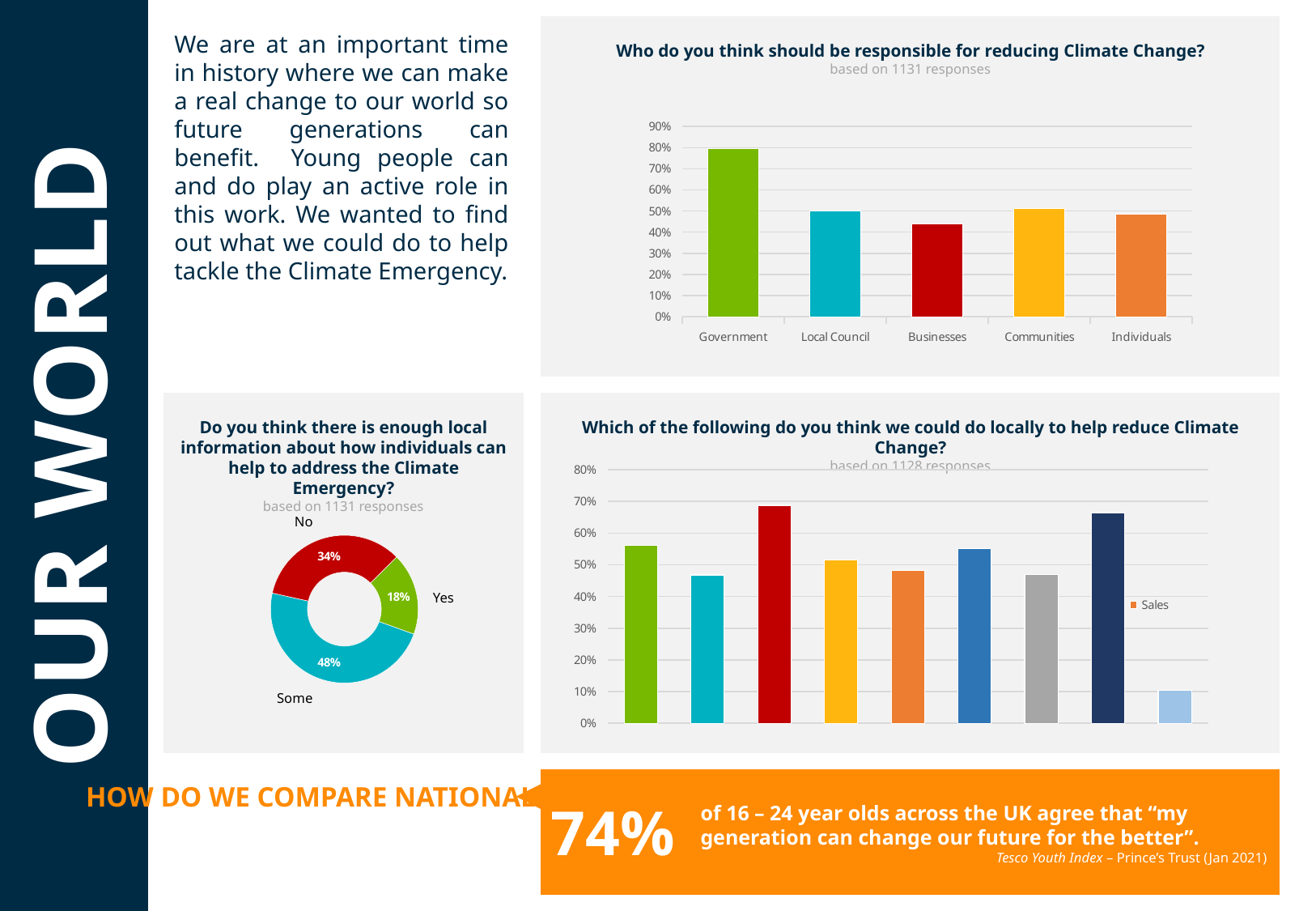
In the doughnut chart about whether there is enough local information on the Climate Emergency, which response has the smallest share? Yes In the doughnut chart about whether there is enough local information on the Climate Emergency, what share of responses is 'Some'? 48% In the chart titled 'Who do you think should be responsible for reducing Climate Change?', is the value for Government greater or less than 70%? greater In the doughnut chart about whether there is enough local information on the Climate Emergency, what is the value for 'No'? 34% In the chart titled 'Who do you think should be responsible for reducing Climate Change?', is the value for Businesses greater or less than 50%? less In the chart titled 'Who do you think should be responsible for reducing Climate Change?', what kind of chart is shown? bar chart In the chart titled 'Who do you think should be responsible for reducing Climate Change?', which category has the highest value? Government In the chart titled 'Who do you think should be responsible for reducing Climate Change?', how many categories are plotted? 5 In the chart titled 'Who do you think should be responsible for reducing Climate Change?', which category has the lowest value? Businesses In the chart titled 'Who do you think should be responsible for reducing Climate Change?', which is larger, Government or Local Council? Government In the chart titled 'Which of the following do you think we could do locally to help reduce Climate Change?', how many bars are plotted? 9 In the doughnut chart about whether there is enough local information on the Climate Emergency, what is the difference between the 'No' and 'Yes' shares? 16%